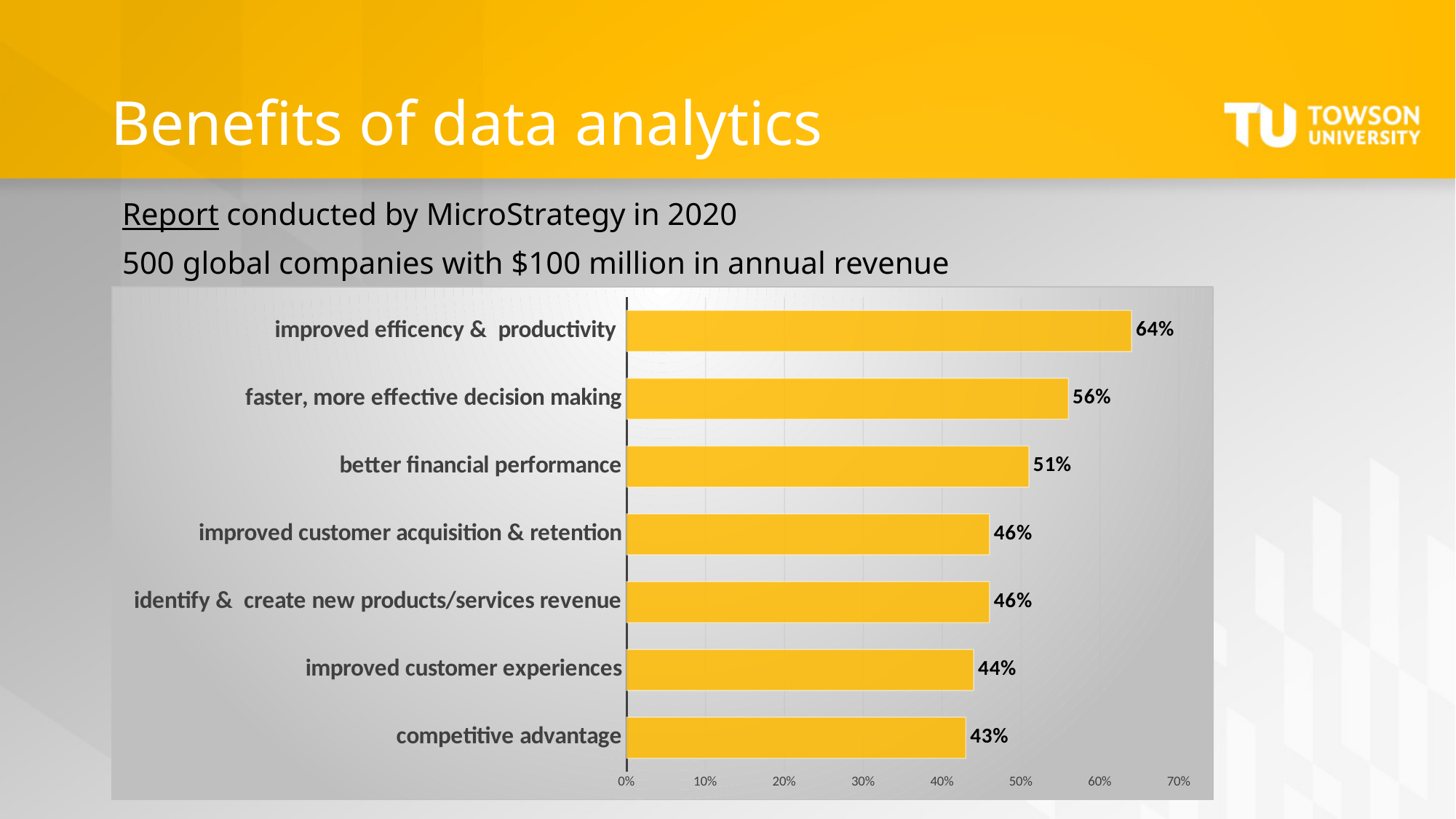
Which category has the lowest value? competitive advantage What colour are the bars in the chart? yellow What is the value for 'improved efficency & productivity'? 64% What is the value for 'competitive advantage'? 43% What is the difference between 'better financial performance' and 'competitive advantage'? 8% What is the difference between 'improved efficency & productivity' and 'faster, more effective decision making'? 8% What is the value for 'improved customer experiences'? 44% What kind of chart is shown on the slide? bar chart Which category has the highest value? improved efficency & productivity What is the value for 'better financial performance'? 51% Which is larger: 'faster, more effective decision making' or 'improved customer acquisition & retention'? faster, more effective decision making How many categories are shown in the chart? 7